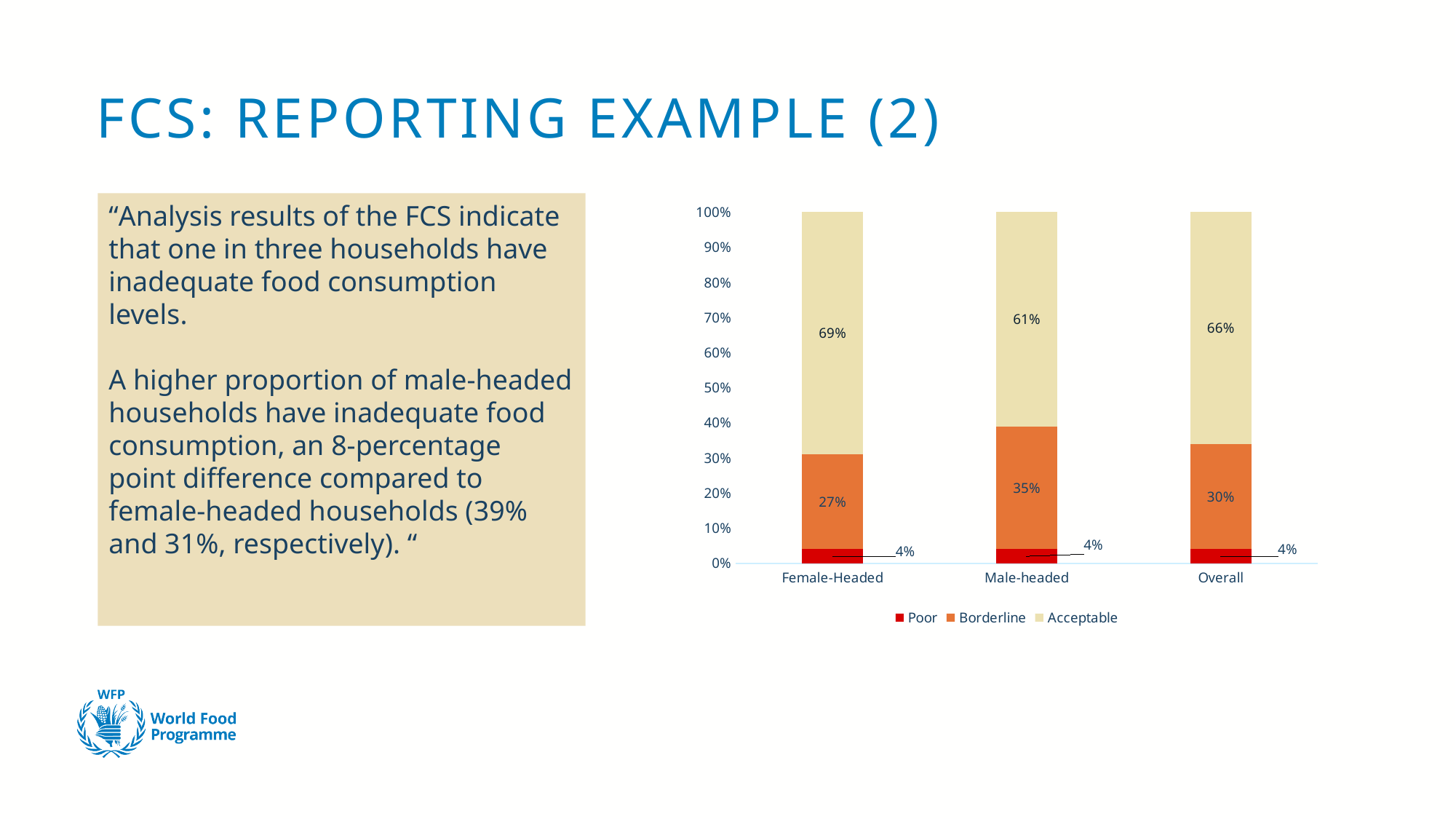
Which category has the highest Acceptable value? Female-Headed What is the Poor value for Overall? 4% What is the Borderline value for Male-headed households? 35% What kind of chart is shown on the slide? Stacked bar chart Which is larger, the Acceptable value for Male-headed or for Overall? Overall Which category has the lowest Borderline value? Female-Headed How many series does the legend list? 3 What is the Acceptable value for Overall? 66% What are the legend entries of the chart? Poor, Borderline, Acceptable How many categories are shown on the x axis? 3 What is the difference between the Borderline values for Male-headed and Female-Headed households? 8% What is the Acceptable value for Female-Headed households? 69%